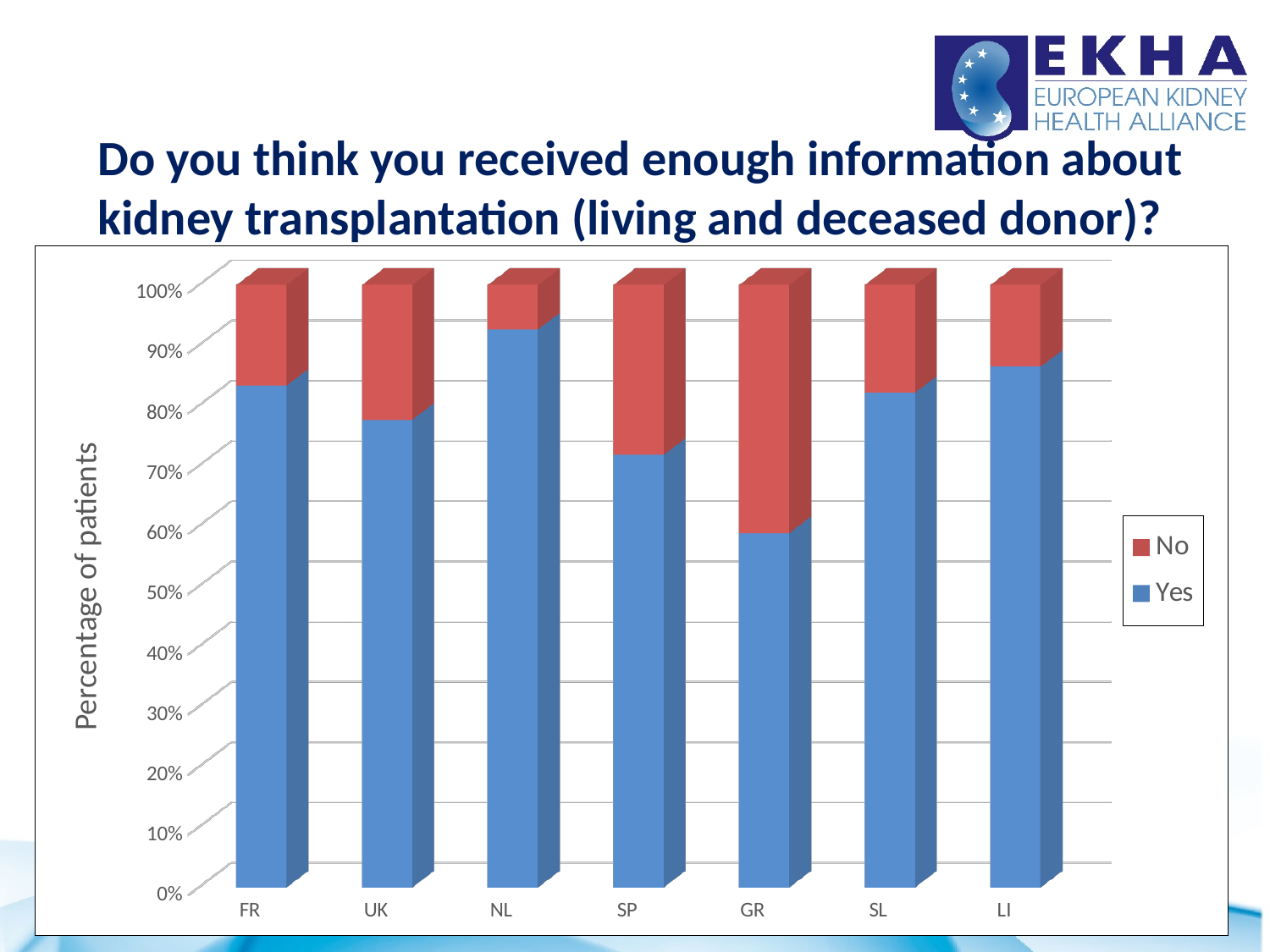
Which country has the lowest share of 'Yes' responses? GR Is the 'Yes' value for GR greater or less than 70%? less How many countries are shown on the x axis of the chart? 7 How many series does the chart legend list? 2 What kind of chart is shown on the slide? stacked bar chart What is the label on the vertical axis of the chart? Percentage of patients Which country has the largest 'No' segment? GR What is the total height of the stacked bar for FR? 100% Is the 'Yes' value for NL greater or less than 90%? greater Is the 'Yes' value for LI greater or less than 80%? greater Which country has the highest share of 'Yes' responses? NL Which has a larger 'Yes' share, FR or SP? FR